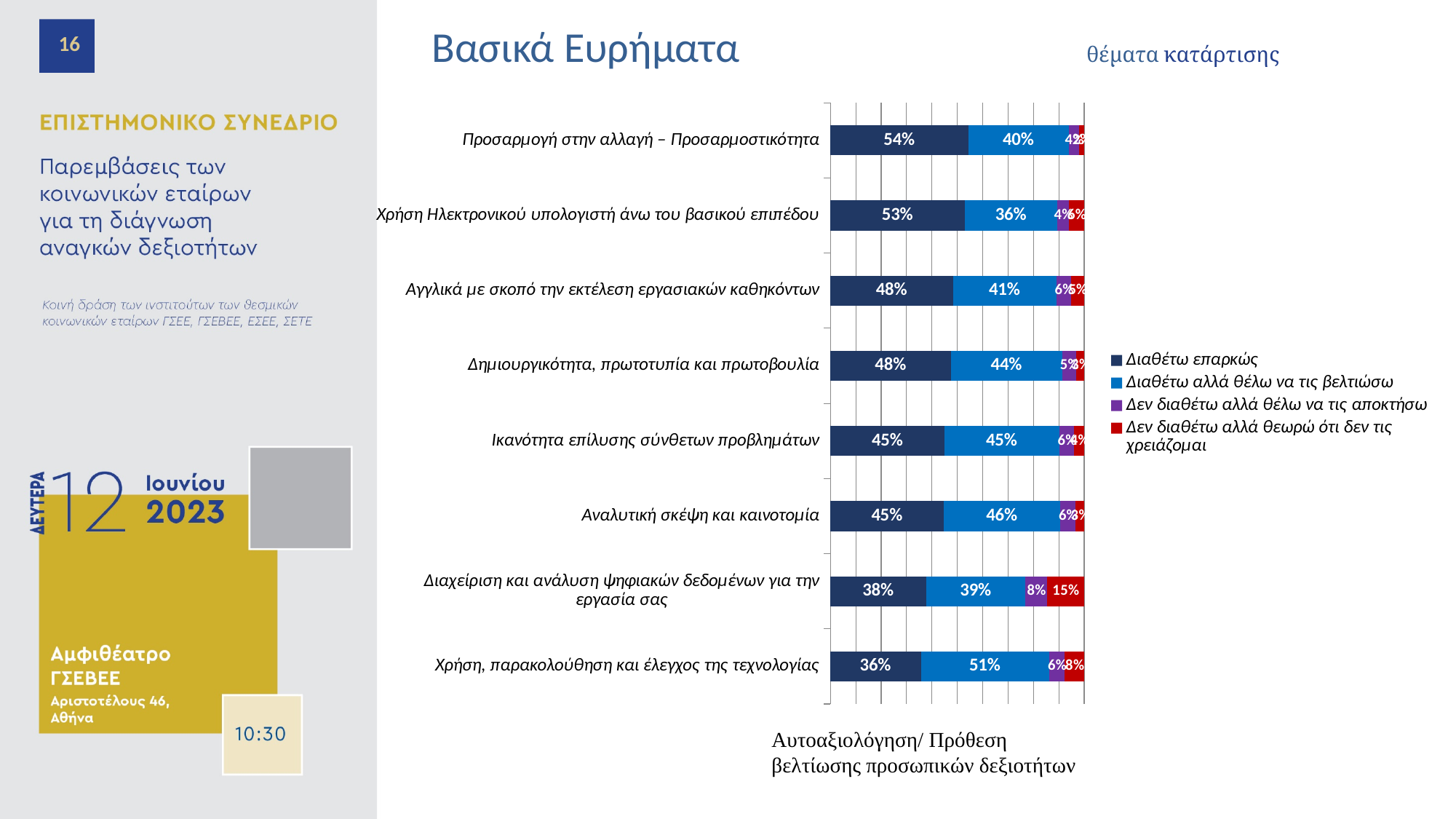
Which category has the highest "Διαθέτω επαρκώς" value? Προσαρμογή στην αλλαγή – Προσαρμοστικότητα How many categories (skills) are shown in the chart? 8 What is the "Δεν διαθέτω αλλά θεωρώ ότι δεν τις χρειάζομαι" value for "Διαχείριση και ανάλυση ψηφιακών δεδομένων για την εργασία σας"? 15% What is the "Διαθέτω αλλά θέλω να τις βελτιώσω" value for "Χρήση, παρακολούθηση και έλεγχος της τεχνολογίας"? 51% Which category has the lowest "Διαθέτω επαρκώς" value? Χρήση, παρακολούθηση και έλεγχος της τεχνολογίας For "Χρήση Ηλεκτρονικού υπολογιστή άνω του βασικού επιπέδου", which is larger: "Διαθέτω επαρκώς" or "Διαθέτω αλλά θέλω να τις βελτιώσω"? Διαθέτω επαρκώς Which category has the highest "Δεν διαθέτω αλλά θεωρώ ότι δεν τις χρειάζομαι" value? Διαχείριση και ανάλυση ψηφιακών δεδομένων για την εργασία σας What is the "Διαθέτω επαρκώς" value for "Χρήση Ηλεκτρονικού υπολογιστή άνω του βασικού επιπέδου"? 53% What percentage of respondents answered "Διαθέτω επαρκώς" for "Προσαρμογή στην αλλαγή – Προσαρμοστικότητα"? 54% How many series does the legend list? 4 What is the difference between the "Διαθέτω επαρκώς" and "Διαθέτω αλλά θέλω να τις βελτιώσω" values for "Προσαρμογή στην αλλαγή – Προσαρμοστικότητα"? 14 percentage points What kind of chart is shown on the slide? Stacked bar chart